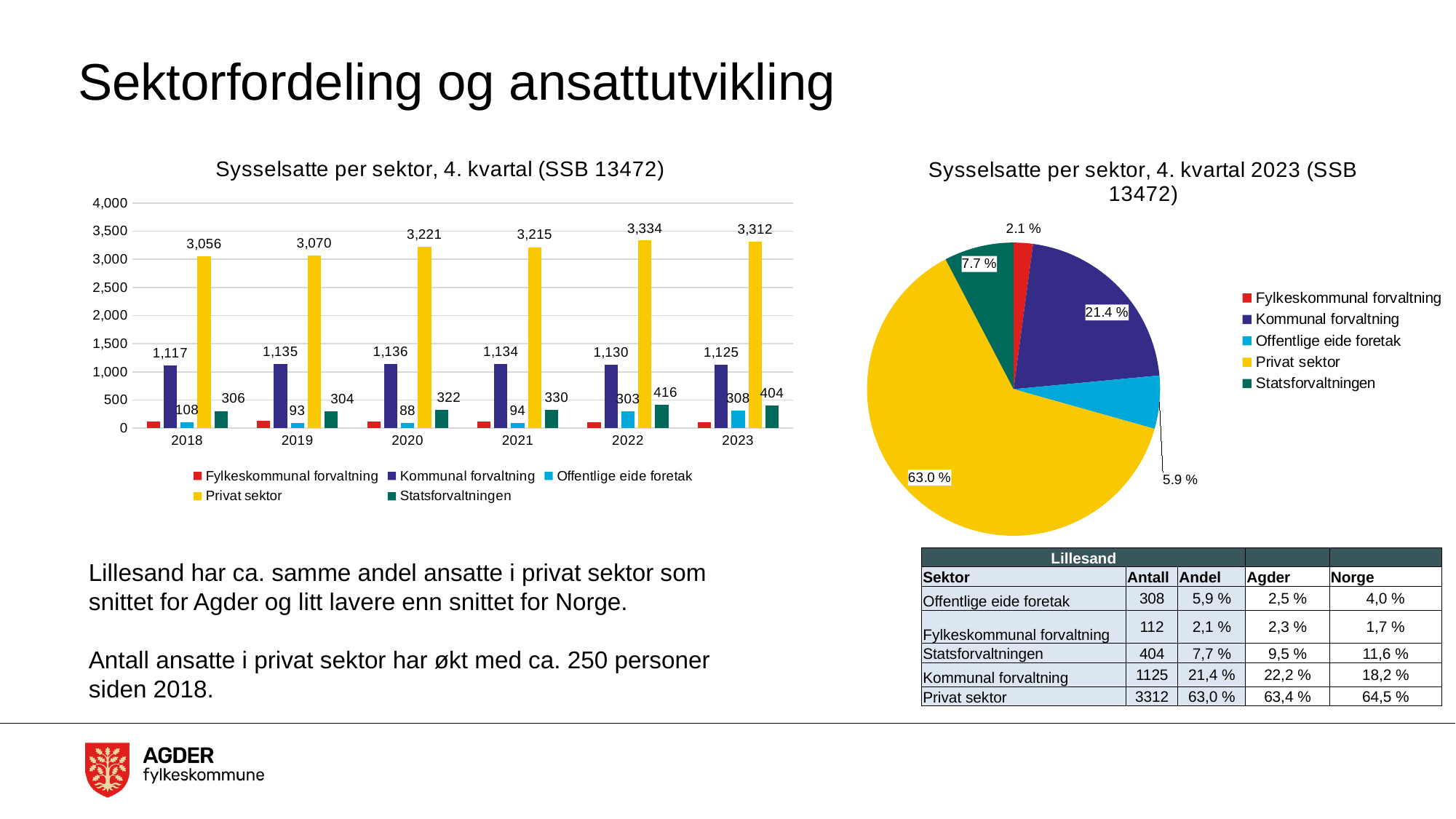
In the bar chart 'Sysselsatte per sektor, 4. kvartal (SSB 13472)', what is the value for Kommunal forvaltning in 2019? 1,135 How many series does the legend of the bar chart 'Sysselsatte per sektor, 4. kvartal (SSB 13472)' list? 5 In the bar chart 'Sysselsatte per sektor, 4. kvartal (SSB 13472)', in which year is the Offentlige eide foretak value lowest? 2020 What kind of chart is 'Sysselsatte per sektor, 4. kvartal 2023 (SSB 13472)' on the right of the slide? pie chart In the bar chart 'Sysselsatte per sektor, 4. kvartal (SSB 13472)', what is the difference between the Privat sektor values in 2023 and 2018? 256 How many years are shown on the x axis of the bar chart 'Sysselsatte per sektor, 4. kvartal (SSB 13472)'? 6 In the bar chart 'Sysselsatte per sektor, 4. kvartal (SSB 13472)', which is larger in 2022: Statsforvaltningen or Offentlige eide foretak? Statsforvaltningen In the bar chart 'Sysselsatte per sektor, 4. kvartal (SSB 13472)', what is the value for Privat sektor in 2022? 3,334 In the bar chart 'Sysselsatte per sektor, 4. kvartal (SSB 13472)', in which year is the Privat sektor value highest? 2022 In the pie chart 'Sysselsatte per sektor, 4. kvartal 2023 (SSB 13472)', what share does Kommunal forvaltning have? 21.4 % In the bar chart 'Sysselsatte per sektor, 4. kvartal (SSB 13472)', what is the value for Statsforvaltningen in 2021? 330 In the bar chart 'Sysselsatte per sektor, 4. kvartal (SSB 13472)', is the value for Fylkeskommunal forvaltning in 2018 greater or less than 500? less